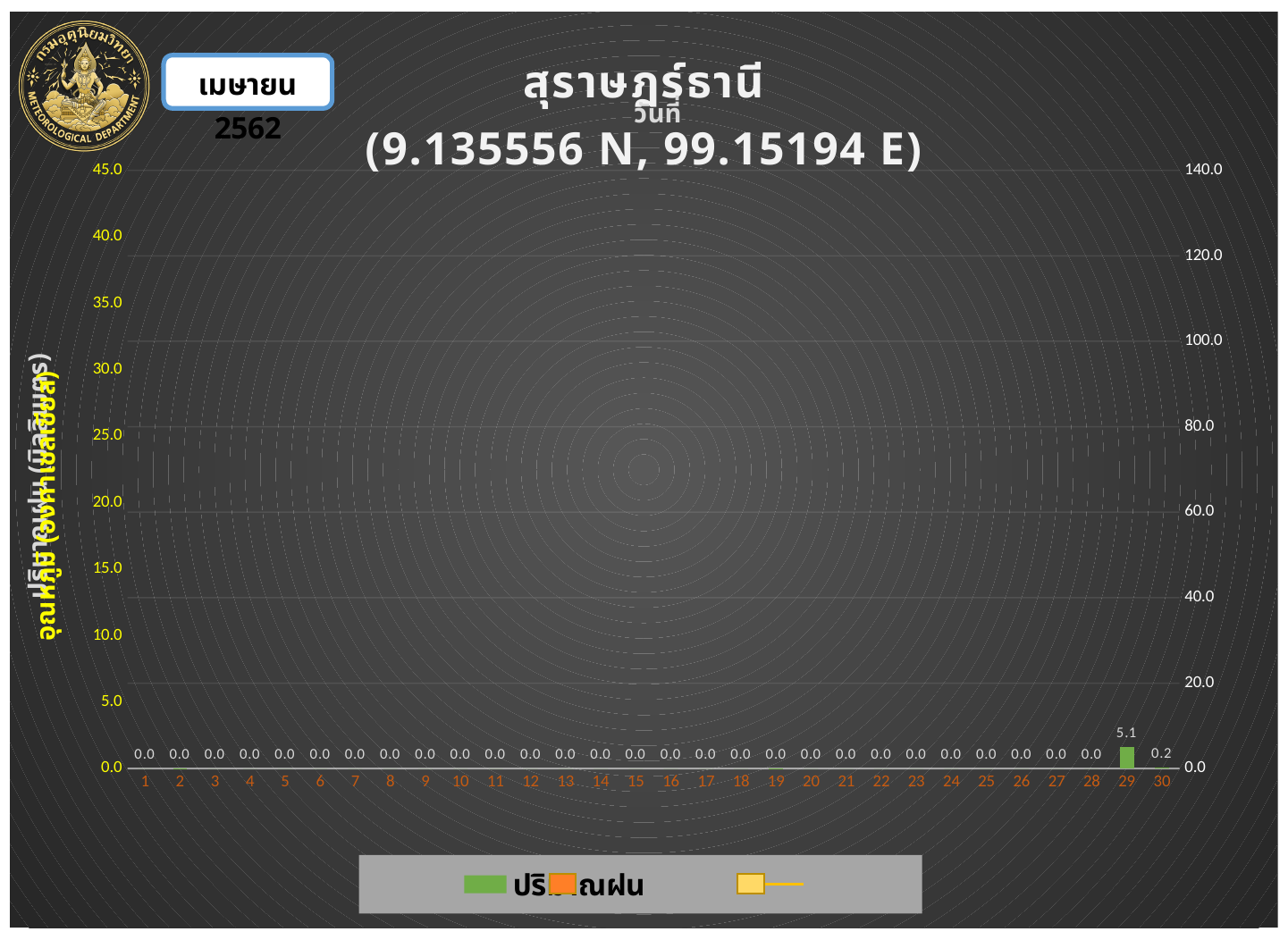
What is the highest tick value on the right vertical axis? 140.0 What is the value shown for day 1? 0.0 Is the value for day 29 greater or less than 10.0? less Which has the larger value, day 29 or day 30? 29 Which day has the highest value? 29 What is the value shown for day 29? 5.1 How many days are shown on the x axis? 30 What is the value shown for day 15? 0.0 What is the value shown for day 30? 0.2 What is the highest tick value on the left vertical axis? 45.0 What kind of chart is this? bar chart What is the difference between the values for day 29 and day 30? 4.9